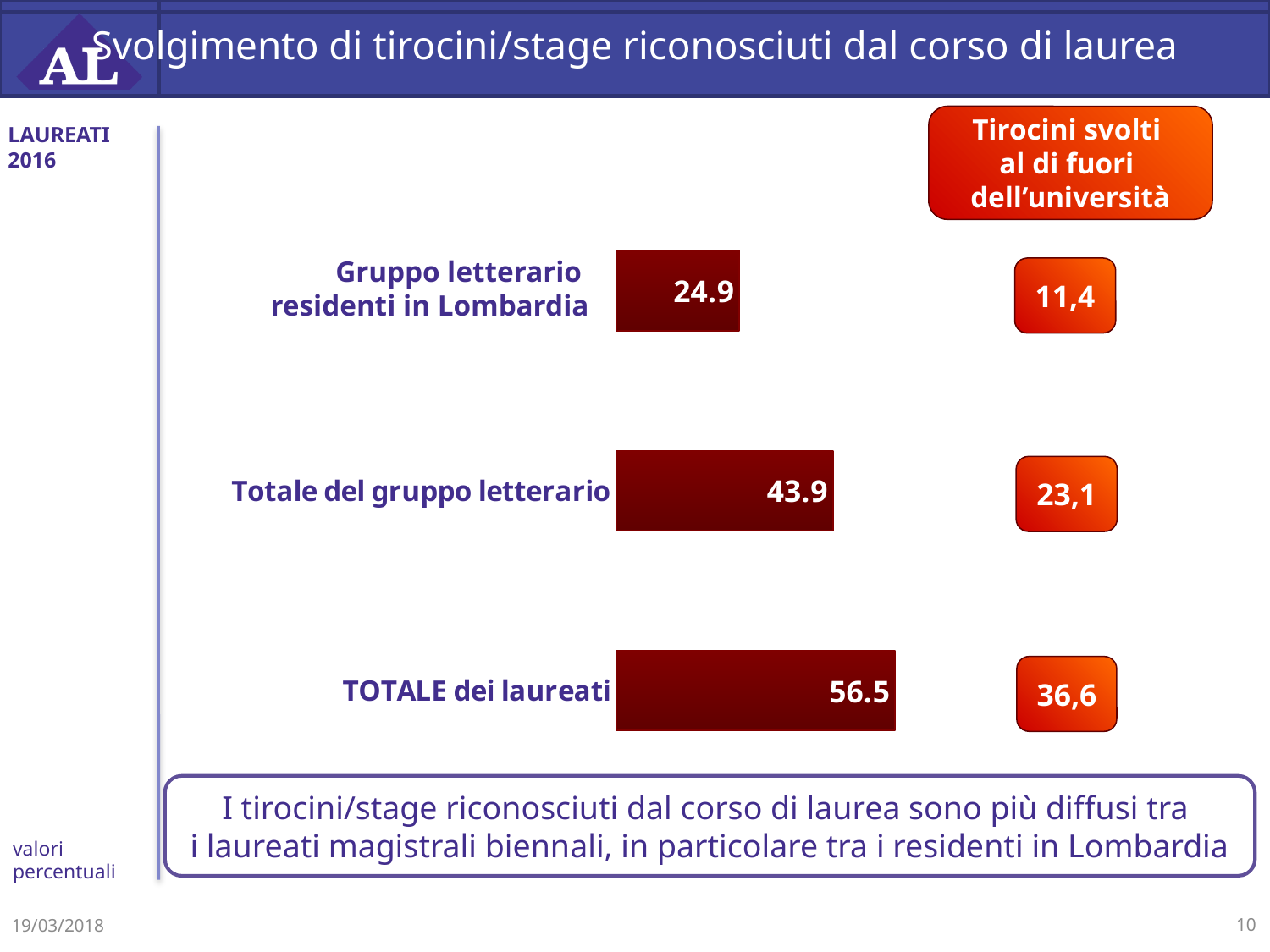
Which category has the lowest value in the bar chart? Gruppo letterario residenti in Lombardia What is the difference between the values for 'Totale del gruppo letterario' and 'Gruppo letterario residenti in Lombardia'? 19.0 What unit do the values in the chart represent, according to the note at the bottom left of the slide? valori percentuali In the 'Tirocini svolti al di fuori dell'università' boxes next to the chart, what value is shown for 'TOTALE dei laureati'? 36,6 What is the value for 'Gruppo letterario residenti in Lombardia' in the bar chart? 24.9 How many categories are shown in the bar chart? 3 Which is larger: the value for 'Totale del gruppo letterario' or the value for 'Gruppo letterario residenti in Lombardia'? Totale del gruppo letterario What kind of chart is shown on the slide? Bar chart What is the value for 'TOTALE dei laureati' in the bar chart? 56.5 Which category has the highest value in the bar chart? TOTALE dei laureati What is the difference between the values for 'TOTALE dei laureati' and 'Totale del gruppo letterario'? 12.6 What is the value for 'Totale del gruppo letterario' in the bar chart? 43.9